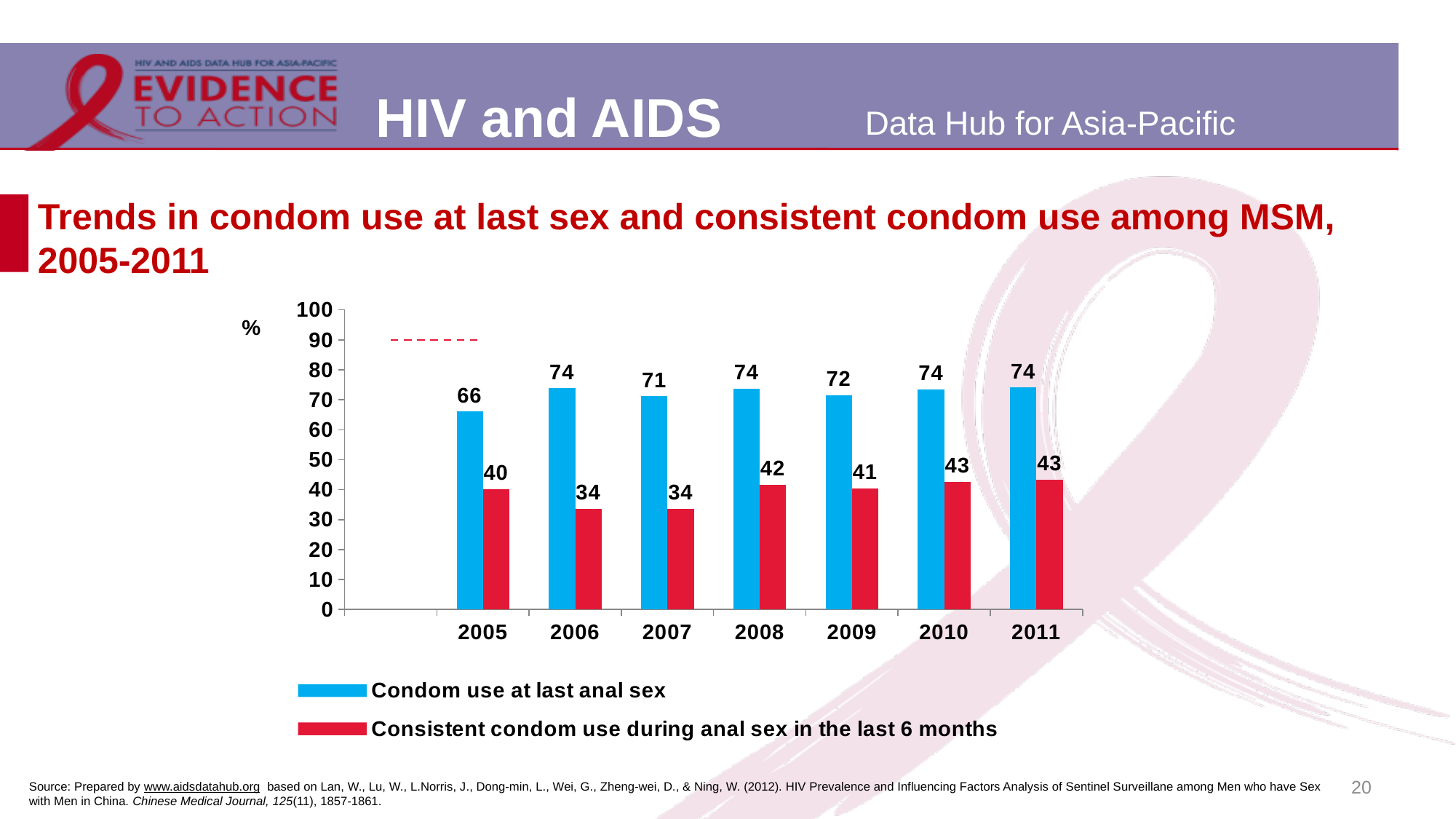
How many series does the legend list? 2 Which year has the highest value for Consistent condom use during anal sex in the last 6 months? 2010 and 2011 (both 43) What is the value for Consistent condom use during anal sex in the last 6 months in 2007? 34 Is the value for Consistent condom use during anal sex in the last 6 months in 2006 greater or less than 40? less What is the value for Condom use at last anal sex in 2005? 66 What is the difference between Condom use at last anal sex and Consistent condom use during anal sex in the last 6 months in 2008? 32 How many years are shown on the x axis? 7 What is the value for Consistent condom use during anal sex in the last 6 months in 2011? 43 Which year has the lowest value for Condom use at last anal sex? 2005 Which colour represents Condom use at last anal sex in the chart? blue What kind of chart is shown on the slide? bar chart Which is larger in 2009: Condom use at last anal sex or Consistent condom use during anal sex in the last 6 months? Condom use at last anal sex